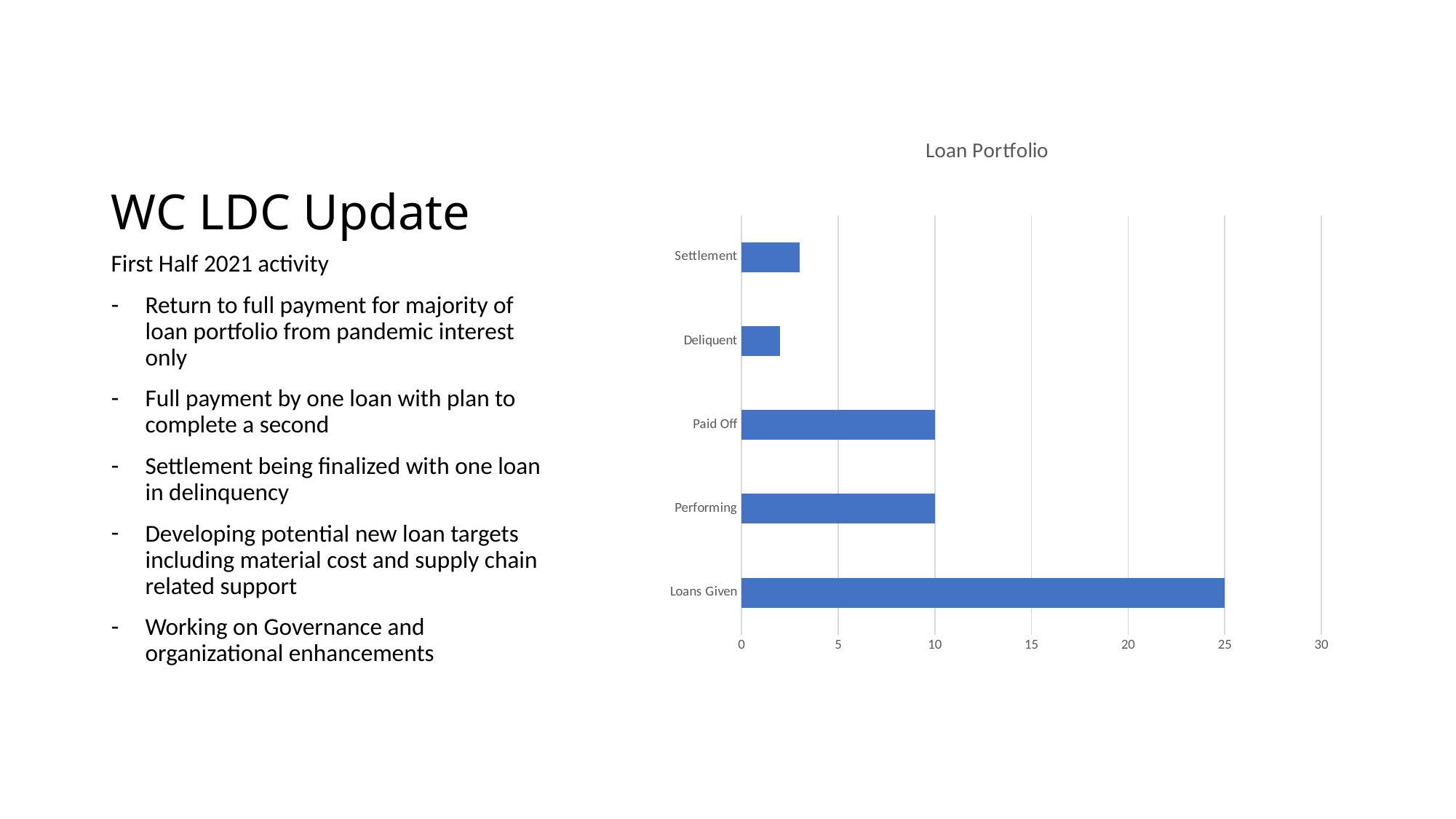
What is the difference between the values for Loans Given and Paid Off? 15 Is the value for Deliquent greater or less than 5? less How many categories are plotted in the Loan Portfolio chart? 5 Is the value for Settlement greater or less than 5? less Which category has the highest value in the Loan Portfolio chart? Loans Given What is the value for Paid Off? 10 Which is larger, the value for Settlement or the value for Deliquent? Settlement What kind of chart is shown on the slide? bar chart What is the value for Loans Given? 25 Which category has the lowest value in the Loan Portfolio chart? Deliquent What is the title of the chart? Loan Portfolio What is the value for Performing? 10